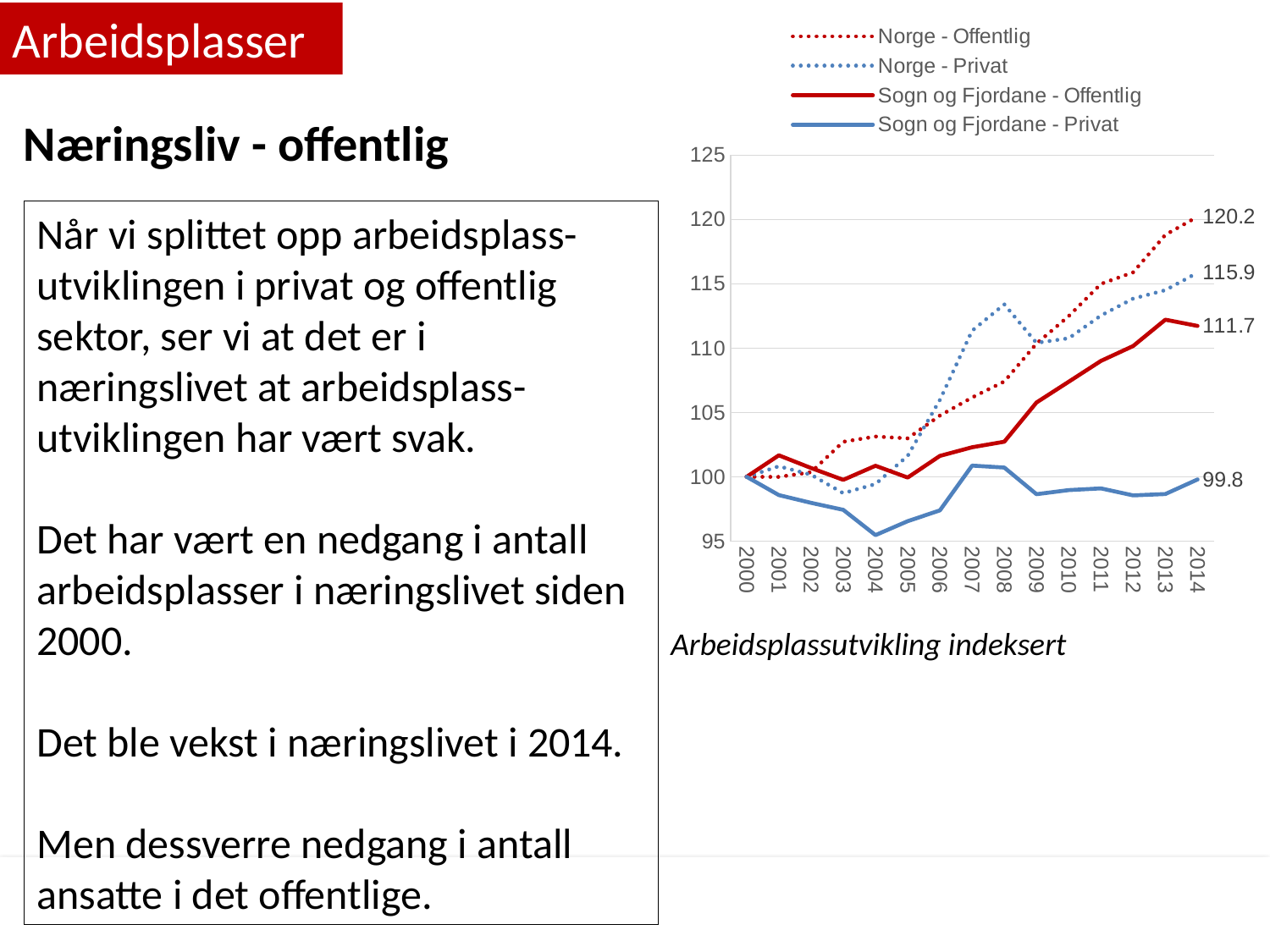
What is the value of the Norge - Privat series in 2014? 115.9 In 2014, which is larger: Norge - Privat or Sogn og Fjordane - Offentlig? Norge - Privat What is the value of the Sogn og Fjordane - Offentlig series in 2014? 111.7 What is the value of the Sogn og Fjordane - Privat series in 2014? 99.8 What kind of chart is shown on the slide? Line chart How many series does the legend list? 4 Which series has the highest value in 2014? Norge - Offentlig What is the difference between the 2014 values of Norge - Offentlig and Sogn og Fjordane - Offentlig? 8.5 What is the value of the Norge - Offentlig series in 2014? 120.2 Is the value for Sogn og Fjordane - Privat in 2004 greater or less than 100? less Which series has the lowest value in 2014? Sogn og Fjordane - Privat How many years are shown on the x axis? 15